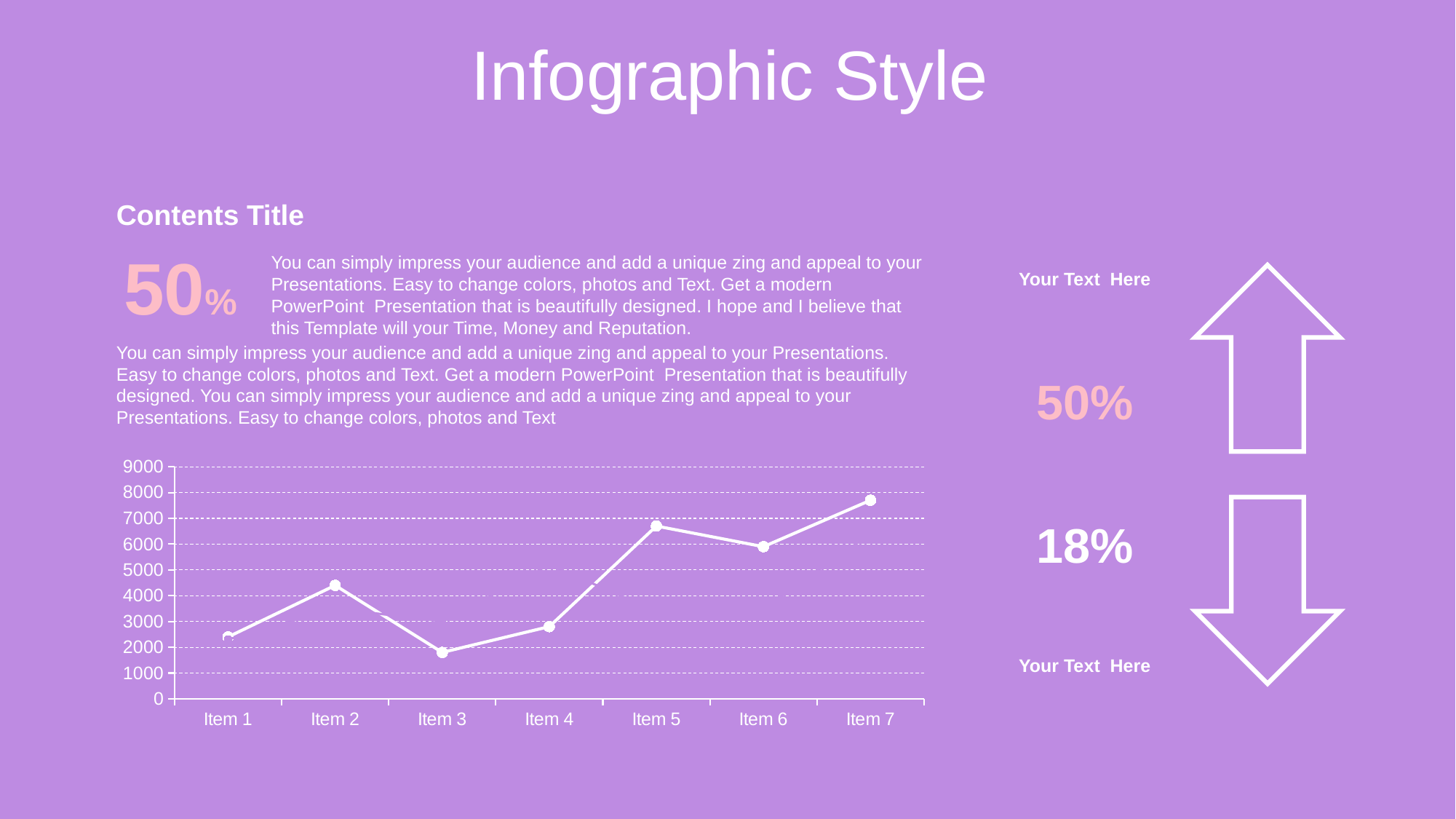
Is the value for Item 2 greater or less than 4000? greater Is the value for Item 3 greater or less than 2000? less What kind of chart is shown on the slide? line chart Does the line rise or fall from Item 4 to Item 5? rise Which item has the lowest value in the chart? Item 3 Is the value for Item 7 greater or less than 7000? greater How many items are plotted along the x axis of the chart? 7 What is the highest value shown on the chart's vertical axis? 9000 Which is larger, the value for Item 5 or the value for Item 6? Item 5 Which item has the highest value in the chart? Item 7 Which is larger, the value for Item 2 or the value for Item 4? Item 2